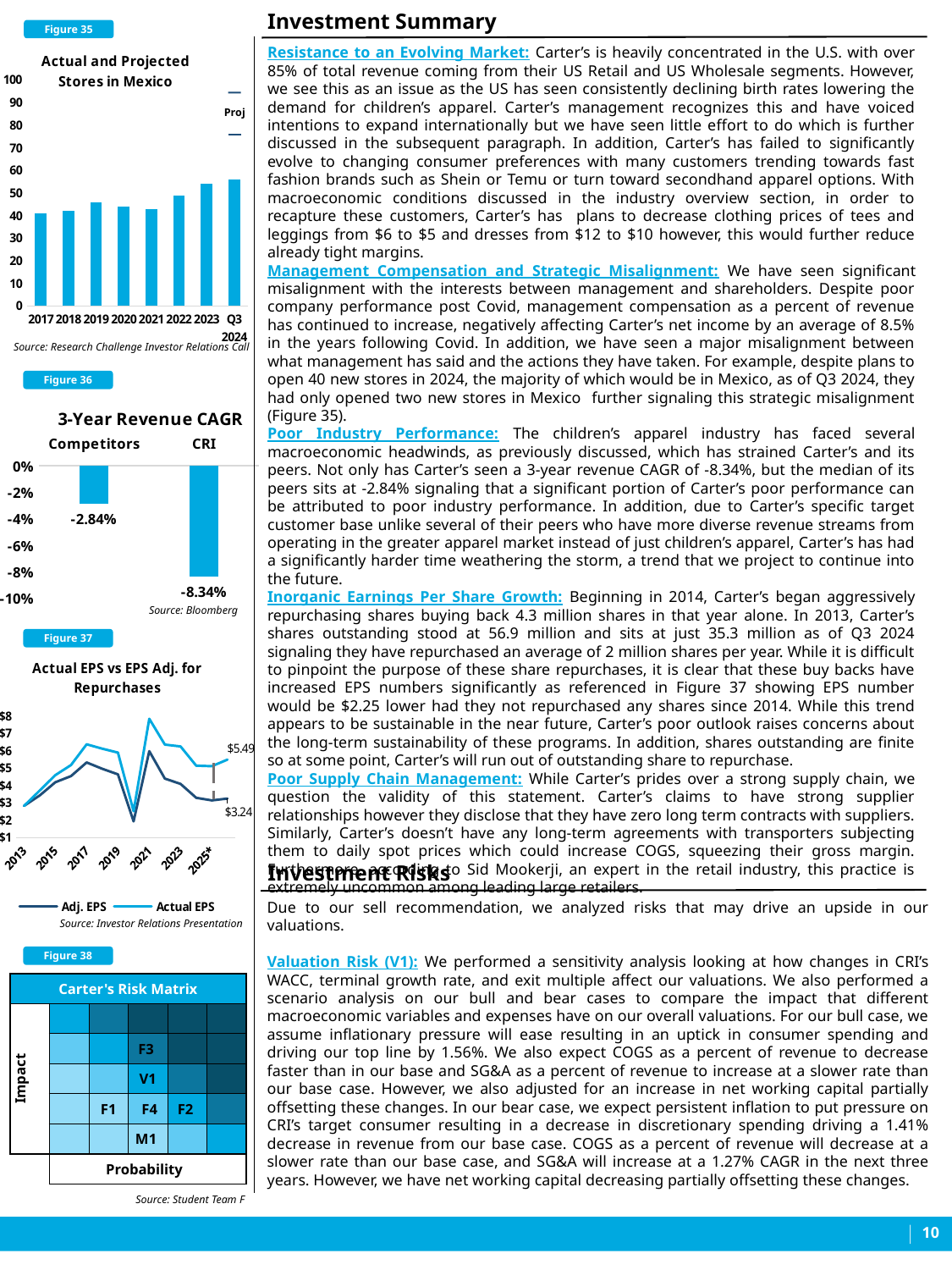
In the '3-Year Revenue CAGR' chart (Figure 36), what is the difference between the Competitors value and the CRI value? 5.50 percentage points In the 'Actual and Projected Stores in Mexico' chart (Figure 35), which category has the tallest bar? Q3 2024 In the 'Actual and Projected Stores in Mexico' chart (Figure 35), is the value for 2023 greater or less than 50? greater In the '3-Year Revenue CAGR' chart (Figure 36), what is the value for Competitors? -2.84% In the '3-Year Revenue CAGR' chart (Figure 36), what is the value for CRI? -8.34% What kind of chart is the '3-Year Revenue CAGR' chart (Figure 36)? bar chart In the '3-Year Revenue CAGR' chart (Figure 36), which category has the lower value? CRI In the 'Actual and Projected Stores in Mexico' chart (Figure 35), is the value for 2017 greater or less than 50? less How many series does the legend list in the 'Actual EPS vs EPS Adj. for Repurchases' chart (Figure 37)? 2 How many categories are shown on the x axis of the 'Actual and Projected Stores in Mexico' chart (Figure 35)? 8